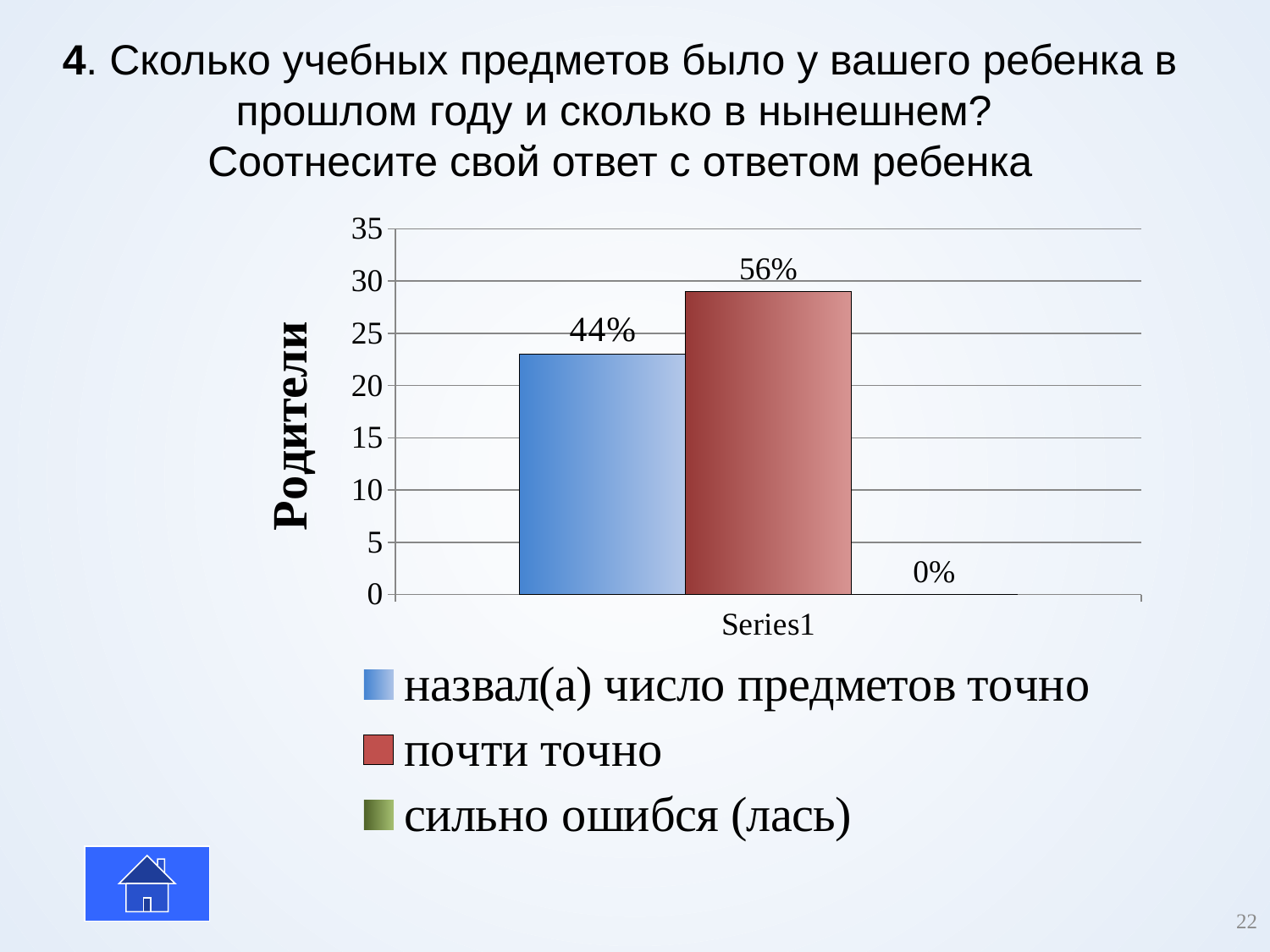
How many series does the legend list? 3 Is the bar for "почти точно" greater or less than 30 on the vertical axis? less Is the bar for "назвал(а) число предметов точно" greater or less than 20 on the vertical axis? greater Which series has the lowest value? сильно ошибся (лась) Which series has the highest value? почти точно What data label is shown for the series "почти точно"? 56% Which is larger: the value for "назвал(а) число предметов точно" or the value for "почти точно"? почти точно What is the difference between the data labels for "почти точно" and "назвал(а) число предметов точно"? 12% What data label is shown for the series "назвал(а) число предметов точно"? 44% What kind of chart is shown on the slide? bar chart What is the title of the vertical axis? Родители What data label is shown for the series "сильно ошибся (лась)"? 0%